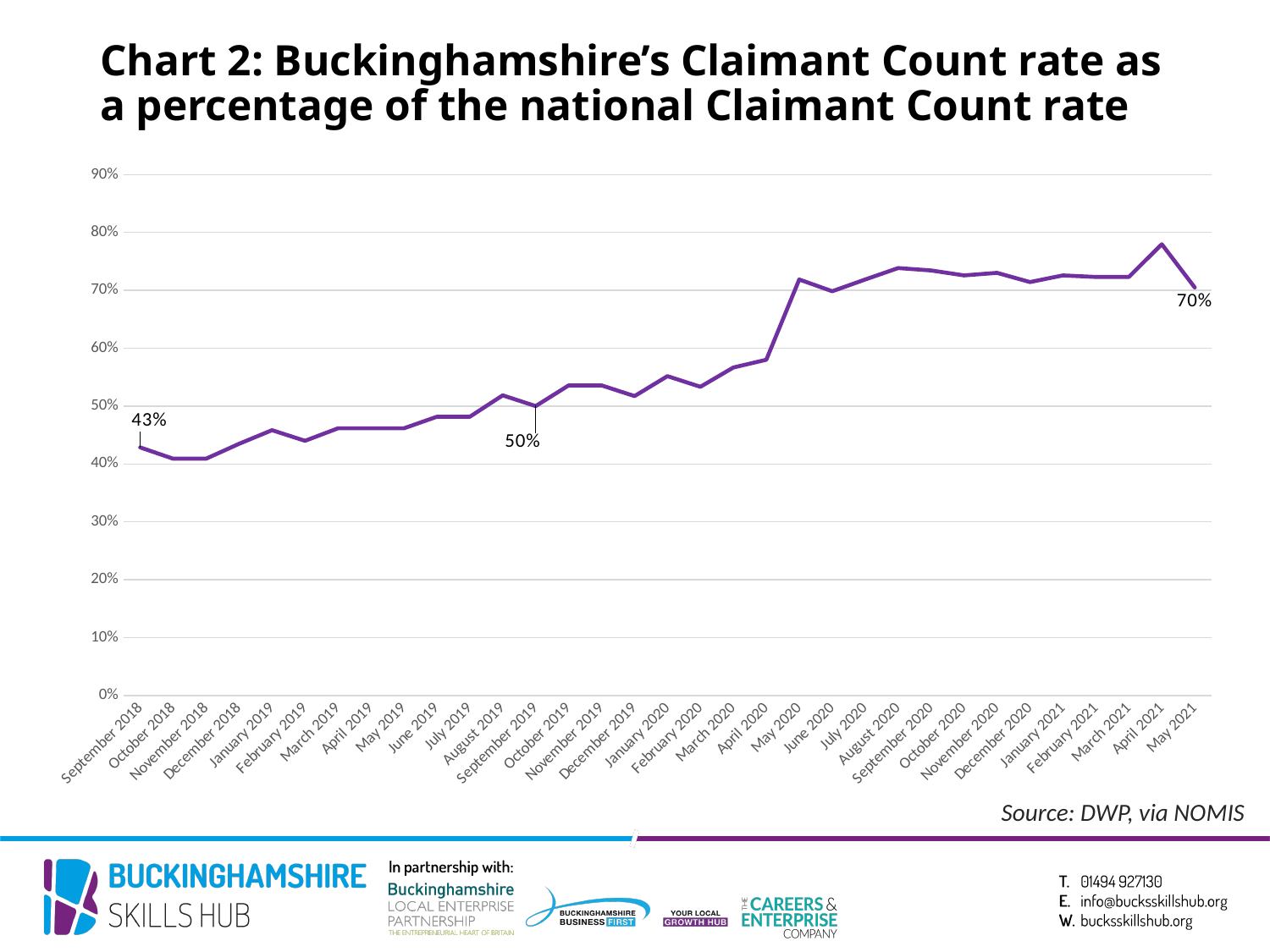
What is the value for September 2018? 43% What type of chart is shown on the slide? line chart What is the difference between the values for May 2021 and September 2018? 27 percentage points What is the value for September 2019? 50% What is the source cited for the chart? DWP, via NOMIS Is the value for March 2020 greater or less than 60%? less Which month has the highest value on the chart? April 2021 Overall, do the values rise or fall from September 2018 to May 2021? rise What is the value for May 2021? 70% What is the difference between the values for September 2019 and September 2018? 7 percentage points Is the value for April 2021 greater or less than 70%? greater Which is larger, the value for September 2019 or the value for September 2018? September 2019